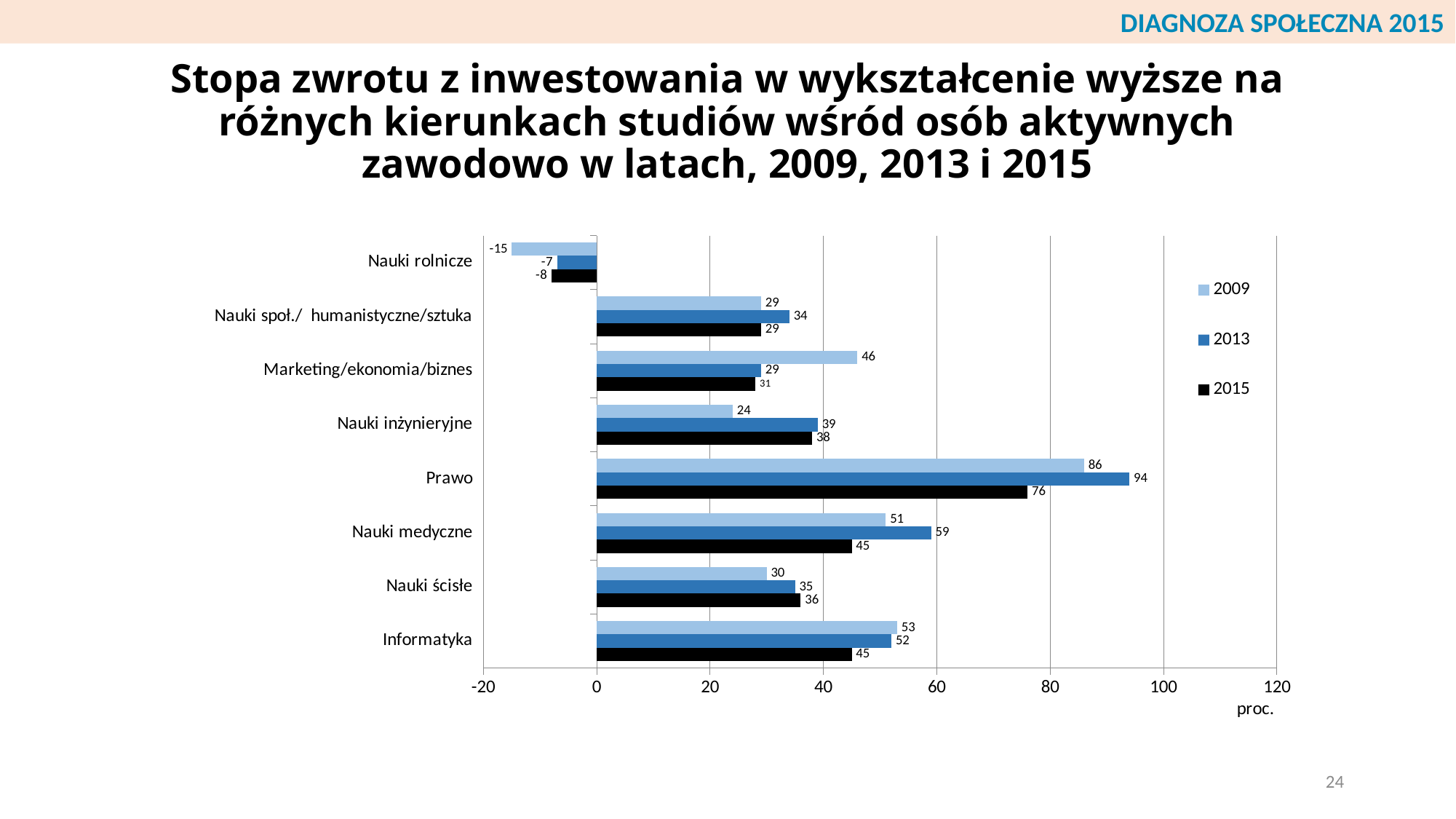
How many series does the legend list? 3 What is the value for Nauki rolnicze in the 2009 series? -15 How many categories are shown on the chart? 8 Which category has the highest value in the 2015 series? Prawo What is the difference between the 2013 and 2015 values for Prawo? 18 What is the difference between the 2009 and 2013 values for Marketing/ekonomia/biznes? 17 Which category has the lowest value in the 2009 series? Nauki rolnicze What is the value for Informatyka in the 2015 series? 45 What is the value for Prawo in the 2013 series? 94 What unit label is shown at the end of the horizontal axis? proc. What kind of chart is shown on the slide? bar chart Which is larger for Nauki inżynieryjne: the 2009 value or the 2013 value? 2013